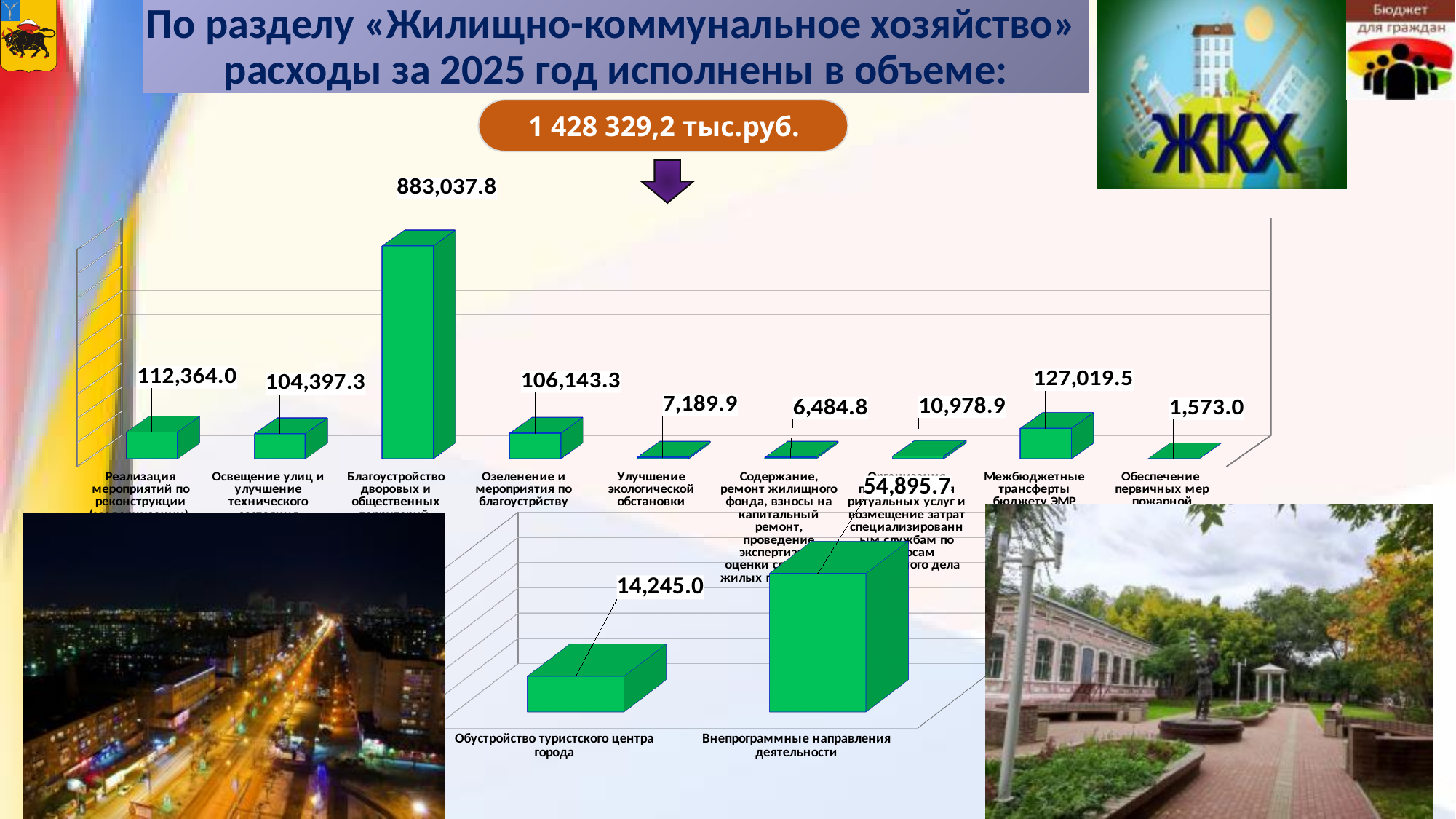
How many categories are shown on the top chart? 9 On the top chart, what is the difference between «Межбюджетные трансферты бюджету ЭМР» and «Озеленение и мероприятия по благоустройству»? 20,876.2 On the top chart, what is the value for «Межбюджетные трансферты бюджету ЭМР»? 127,019.5 On the bottom chart, what is the value for «Внепрограммные направления деятельности»? 54,895.7 On the top chart, what is the value for «Благоустройство дворовых и общественных территорий»? 883,037.8 On the top chart, which category has the lowest value? Обеспечение первичных мер пожарной безопасности What type of chart is the top chart? Bar chart On the bottom chart, what is the value for «Обустройство туристского центра города»? 14,245.0 On the top chart, which category has the highest value? Благоустройство дворовых и общественных территорий On the bottom chart, what is the difference between «Внепрограммные направления деятельности» and «Обустройство туристского центра города»? 40,650.7 On the top chart, which is larger: «Реализация мероприятий по реконструкции» or «Освещение улиц и улучшение технического состояния»? Реализация мероприятий по реконструкции On the top chart, what is the value for «Улучшение экологической обстановки»? 7,189.9